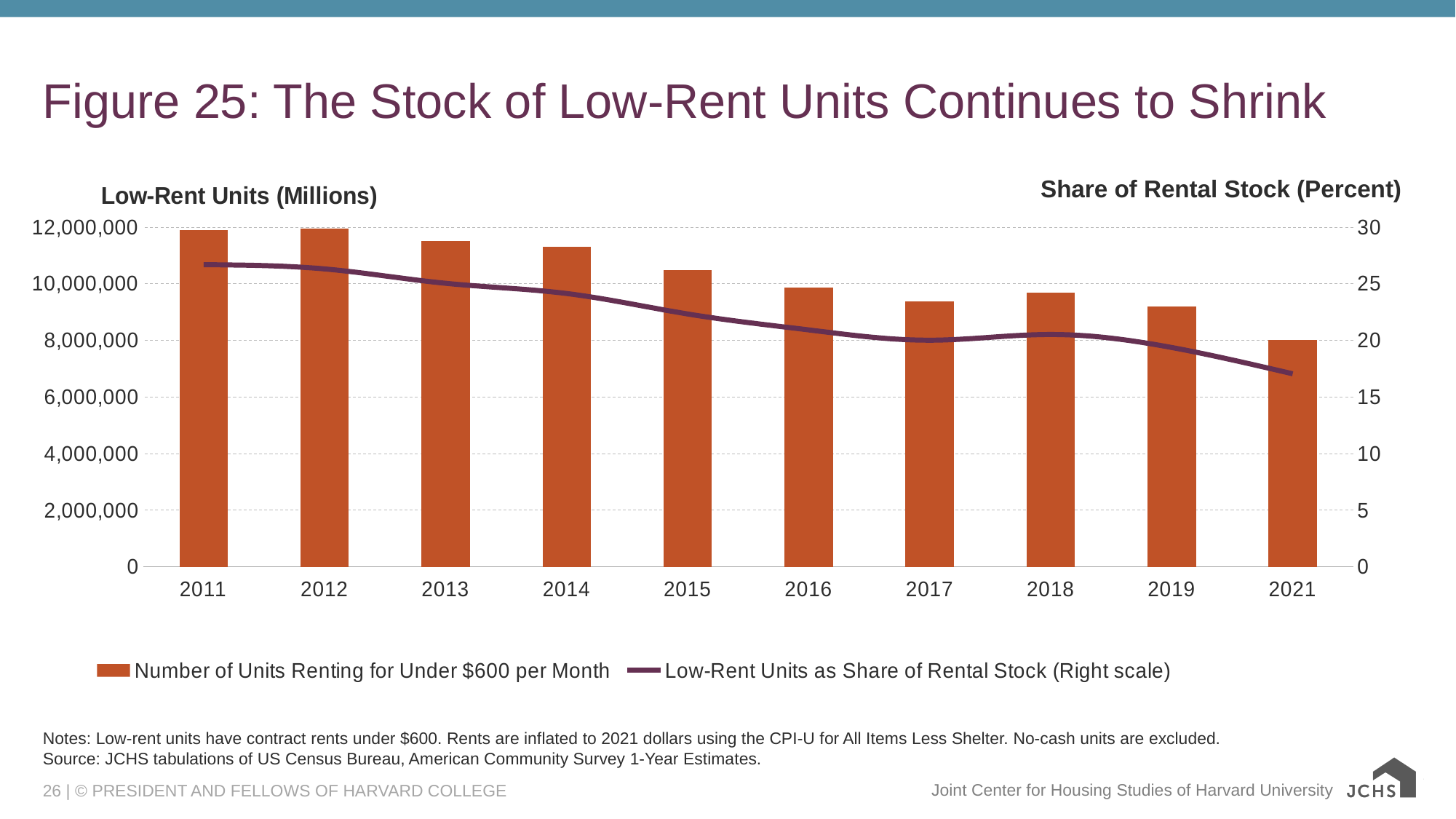
What kind of chart is shown on the slide? A bar chart combined with a line How many years are shown on the x axis of the chart? 10 Does the number of units renting for under $600 per month generally rise or fall from 2011 to 2021? Fall Which year has more units renting for under $600 per month, 2013 or 2016? 2013 What is the title of the figure on the slide? Figure 25: The Stock of Low-Rent Units Continues to Shrink Is the low-rent units share of rental stock in 2011 greater or less than 25 percent? greater Is the number of units renting for under $600 per month in 2021 greater or less than 10,000,000? less Is the number of units renting for under $600 per month in 2015 greater or less than 10,000,000? greater Which year has the lowest number of units renting for under $600 per month? 2021 What is the label of the right-hand axis of the chart? Share of Rental Stock (Percent) How many series does the chart's legend list? 2